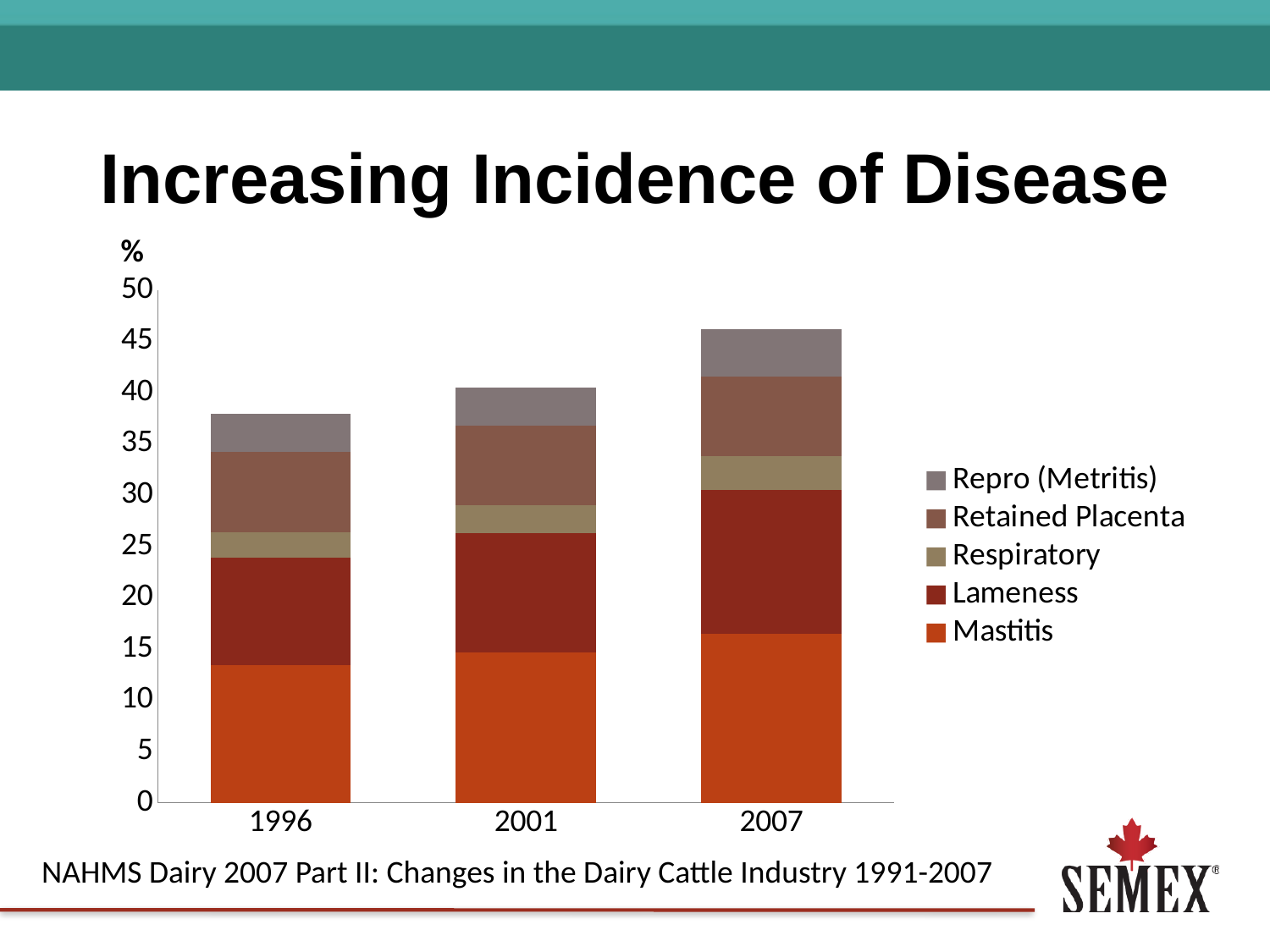
Is the Mastitis value for 1996 greater or less than 15? less How many years (categories) are shown on the x axis? 3 Is the total stacked value for 1996 greater or less than 40? less Is the total stacked value for 2007 greater or less than 40? greater What kind of chart is shown on the slide? Stacked bar chart How many series does the legend list? 5 Do the total bar heights rise or fall from 1996 to 2007? Rise What is the title of the chart on the slide? Increasing Incidence of Disease Which year has the tallest stacked bar? 2007 Which series forms the bottom segment of each stacked bar? Mastitis Which year has the shortest stacked bar? 1996